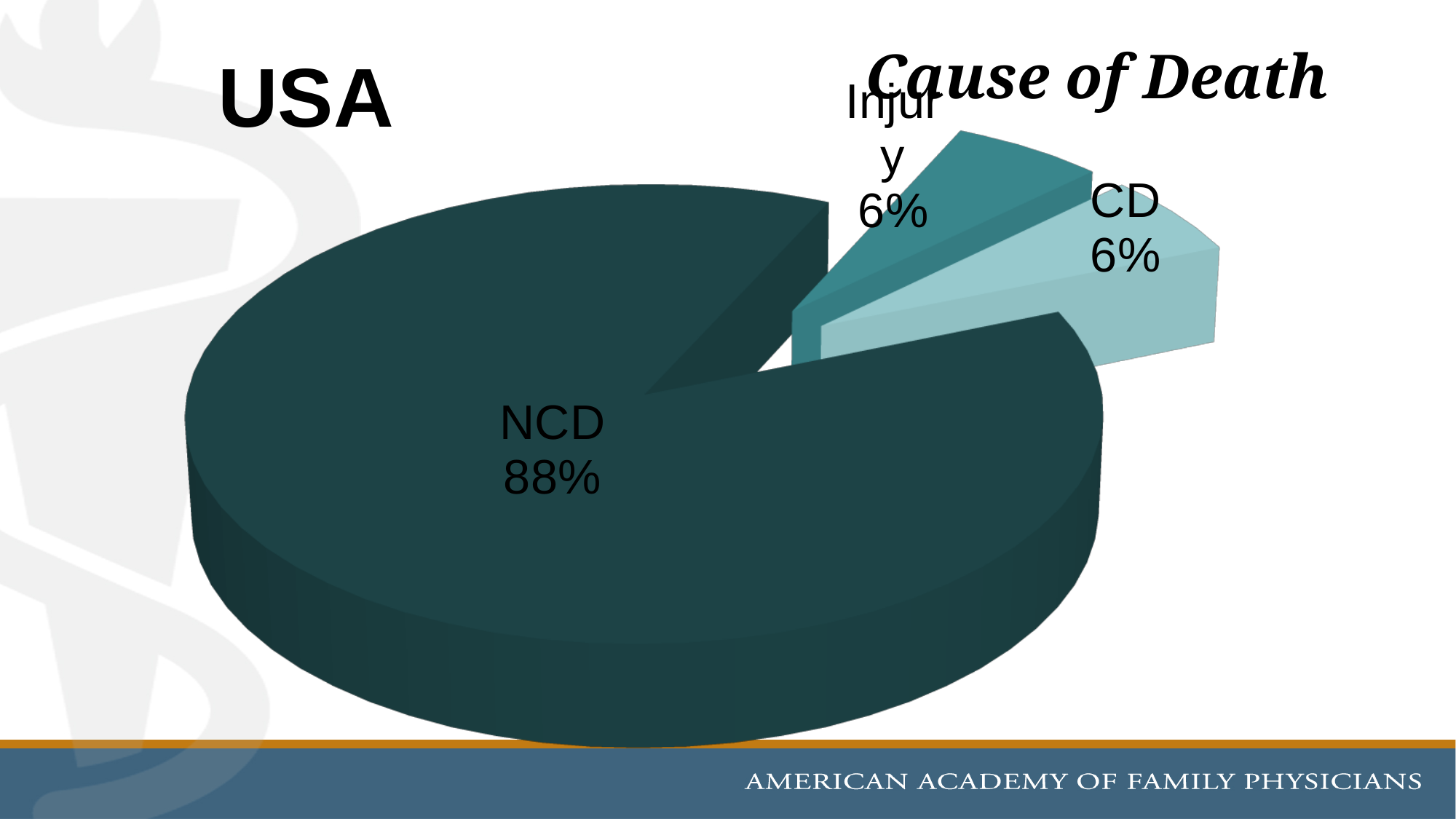
Which is larger, the NCD slice or the Injury slice? NCD What share of the pie does CD account for? 6% How many slices does the pie chart have? 3 Which category has the largest slice of the pie? NCD Which country does the chart refer to? USA What share of the pie does Injury account for? 6% What kind of chart is shown on the slide? pie chart What is the difference in percentage points between the NCD slice and the CD slice? 82 What is the combined share of the CD and Injury slices? 12% What share of the pie does NCD account for? 88% What is the title of the chart? Cause of Death